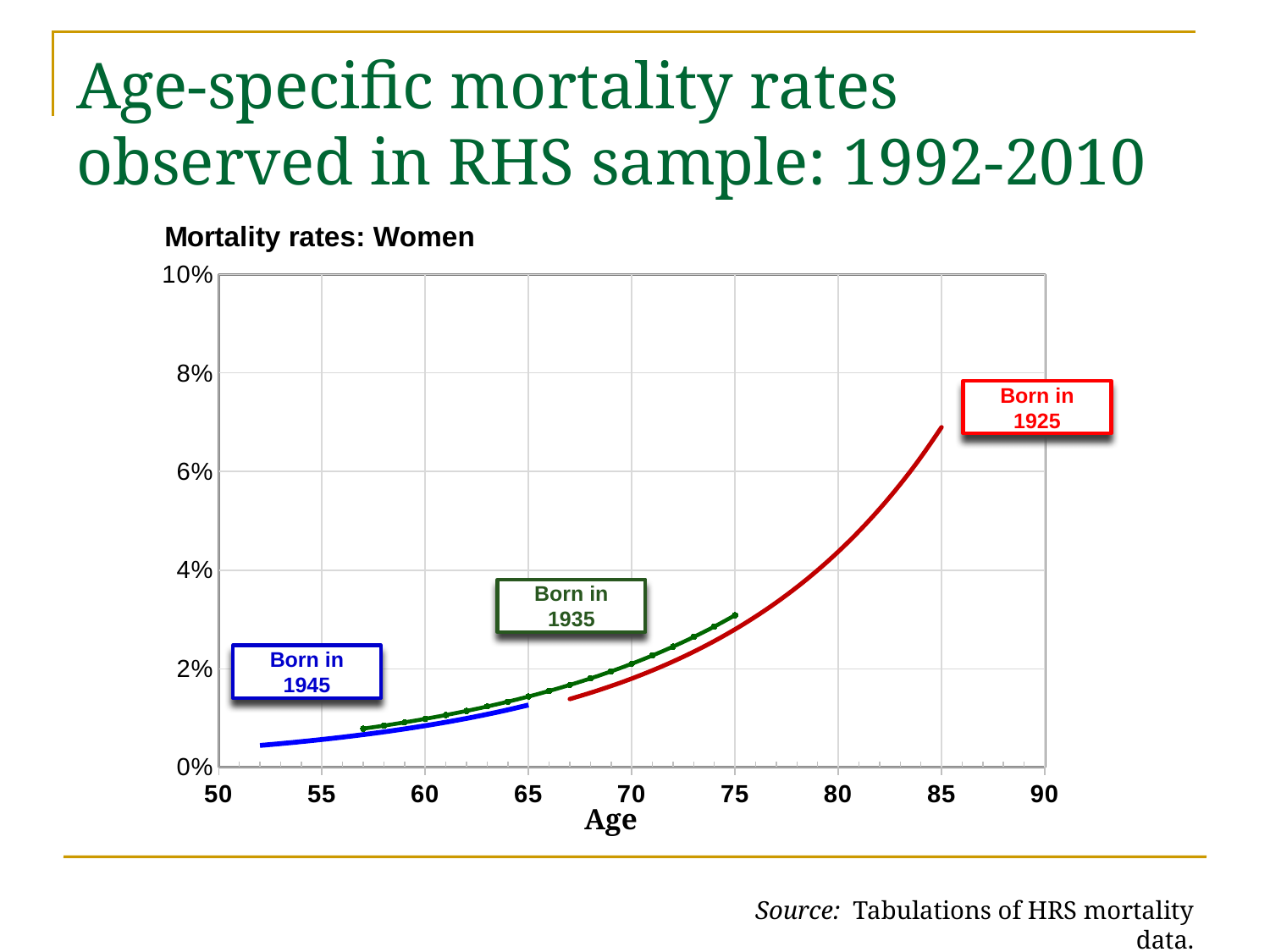
Is the mortality rate for the Born in 1935 cohort at age 75 greater or less than 4%? less Do mortality rates rise or fall as age increases for the Born in 1925 cohort? rise Which cohort's line extends to the oldest ages on the chart? Born in 1925 Which cohort has the higher mortality rate at age 75: Born in 1935 or Born in 1925? Born in 1935 Is the mortality rate for the Born in 1945 cohort at age 65 greater or less than 2%? less Is the mortality rate for the Born in 1925 cohort at age 85 greater or less than 6%? greater How many birth cohorts (series) are plotted on the chart? 3 What is the label of the x axis? Age Which birth cohort reaches the highest mortality rate on the chart? Born in 1925 What kind of chart is shown on the slide? line chart What is the title of the chart? Mortality rates: Women